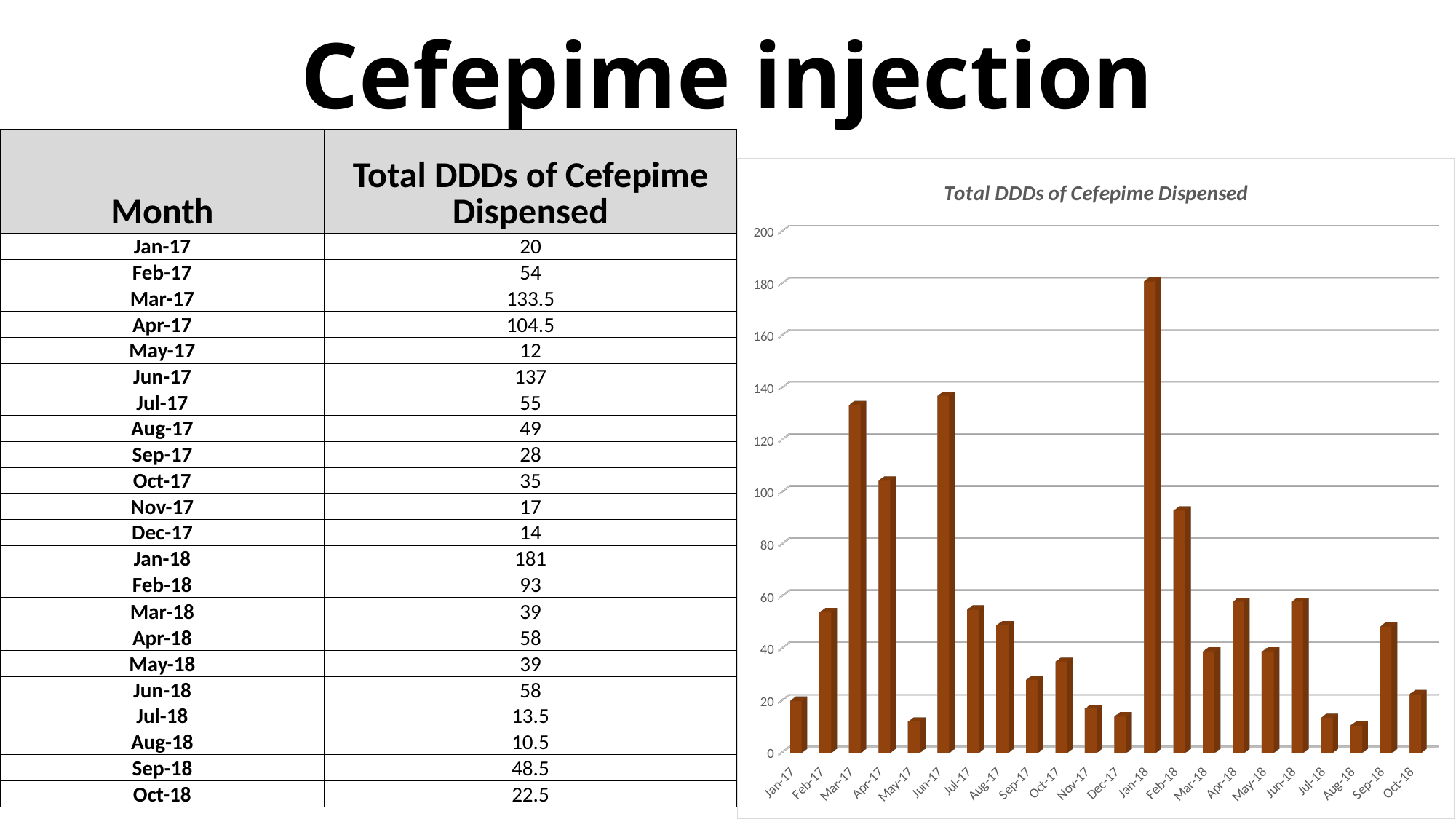
What is the total DDDs of cefepime dispensed in Mar-17? 133.5 Is the value for Feb-18 greater or less than 80? greater What is the total DDDs of cefepime dispensed in Jan-18? 181 What is the total DDDs of cefepime dispensed in Aug-18? 10.5 Which month has the highest total DDDs of cefepime dispensed? Jan-18 Which month has the lowest total DDDs of cefepime dispensed? Aug-18 What is the difference in total DDDs dispensed between Jan-18 and Feb-18? 88 How many months are plotted on the chart? 22 What kind of chart is shown on the slide? bar chart Which month has more DDDs dispensed, Jun-17 or Apr-17? Jun-17 Do the values rise or fall from Jan-18 to Mar-18? fall What is the title of the chart? Total DDDs of Cefepime Dispensed